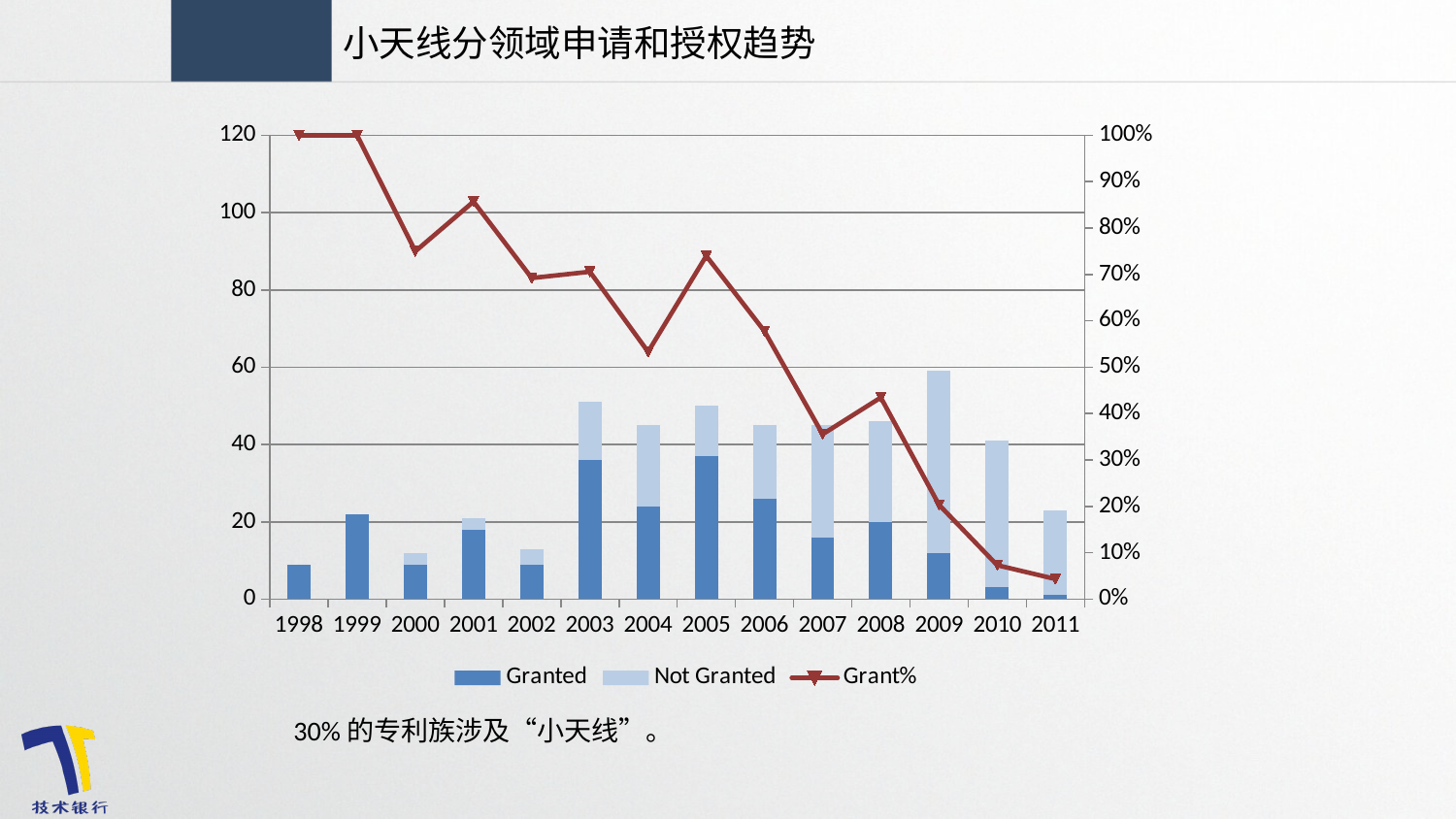
Is the Grant% value for 2011 greater or less than 10%? less Is the total stacked bar for 2009 greater or less than 40? greater What kind of chart is shown on the slide? Bar chart with a line What is the Grant% value for 1998? 100% How many years are shown on the x axis of the chart? 14 How many series does the chart legend list? 3 What is the Grant% value for 1999? 100% Does the Grant% line generally rise or fall from 1998 to 2011? Fall Which year has the tallest stacked bar (Granted plus Not Granted)? 2009 Which year has the smallest Granted value? 2011 What is the title of the chart on the slide? 小天线分领域申请和授权趋势 Which year has the larger Granted value, 2003 or 2007? 2003